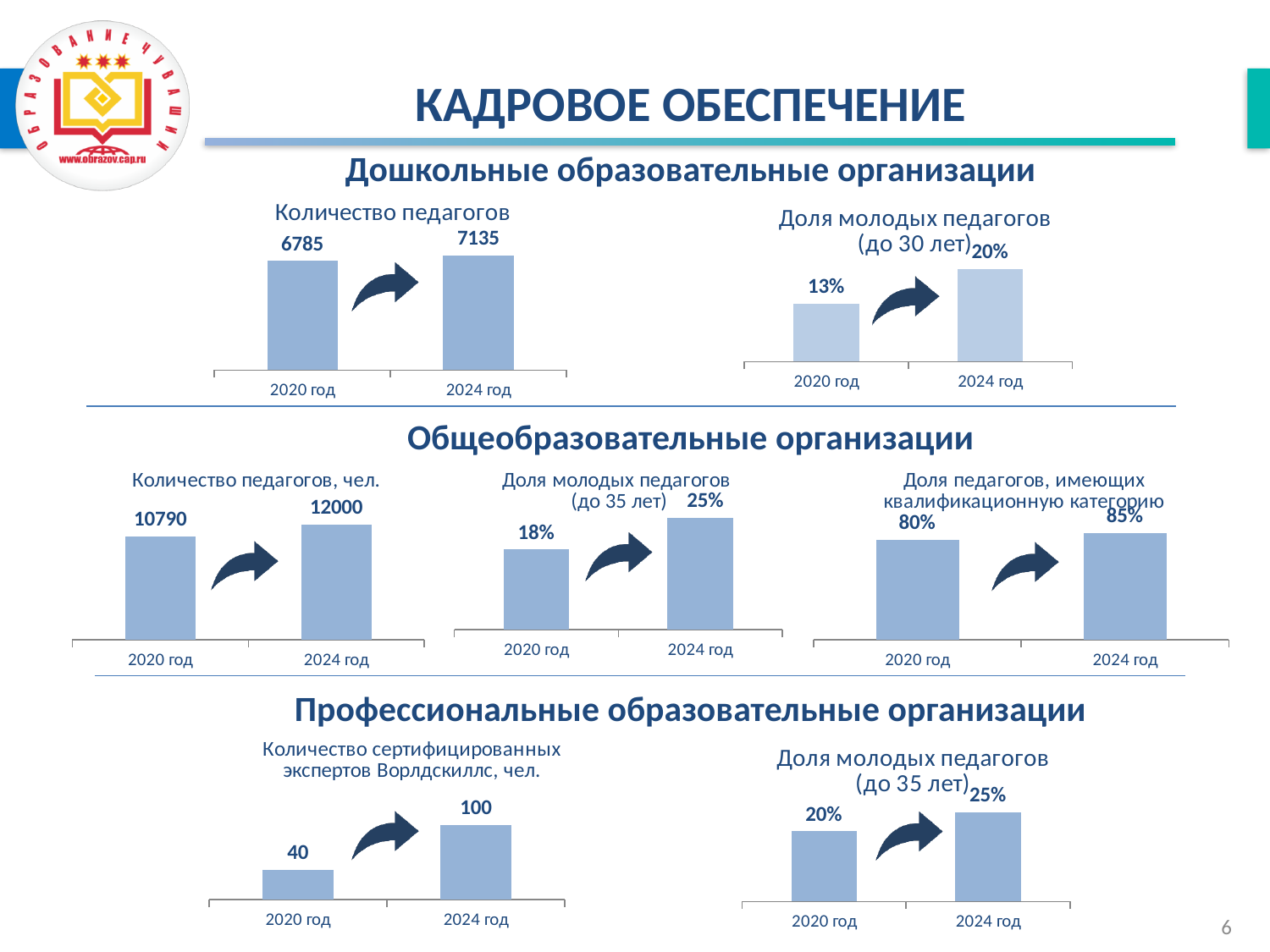
In the 'Количество сертифицированных экспертов Ворлдскиллс, чел.' chart under 'Профессиональные образовательные организации', what is the value for 2020 год? 40 In the 'Доля молодых педагогов (до 35 лет)' chart under 'Общеобразовательные организации', what is the value for 2020 год? 18% In the 'Доля педагогов, имеющих квалификационную категорию' chart under 'Общеобразовательные организации', what is the difference between the 2024 год and 2020 год values? 5% In the 'Количество педагогов, чел.' chart under 'Общеобразовательные организации', what is the value for 2024 год? 12000 What kind of chart is the 'Количество педагогов' chart under 'Дошкольные образовательные организации'? bar chart In the 'Количество педагогов' chart under 'Дошкольные образовательные организации', what is the difference between the 2024 год and 2020 год values? 350 In the 'Количество педагогов' chart under 'Дошкольные образовательные организации', what is the value for 2020 год? 6785 In the 'Количество педагогов, чел.' chart under 'Общеобразовательные организации', what is the difference between the 2024 год and 2020 год values? 1210 In the 'Количество сертифицированных экспертов Ворлдскиллс, чел.' chart under 'Профессиональные образовательные организации', do the values rise or fall from 2020 год to 2024 год? rise In the 'Доля молодых педагогов (до 35 лет)' chart under 'Профессиональные образовательные организации', what is the value for 2020 год? 20% In the 'Доля педагогов, имеющих квалификационную категорию' chart under 'Общеобразовательные организации', which year has the higher value? 2024 год In the 'Доля молодых педагогов (до 30 лет)' chart under 'Дошкольные образовательные организации', what is the value for 2024 год? 20%